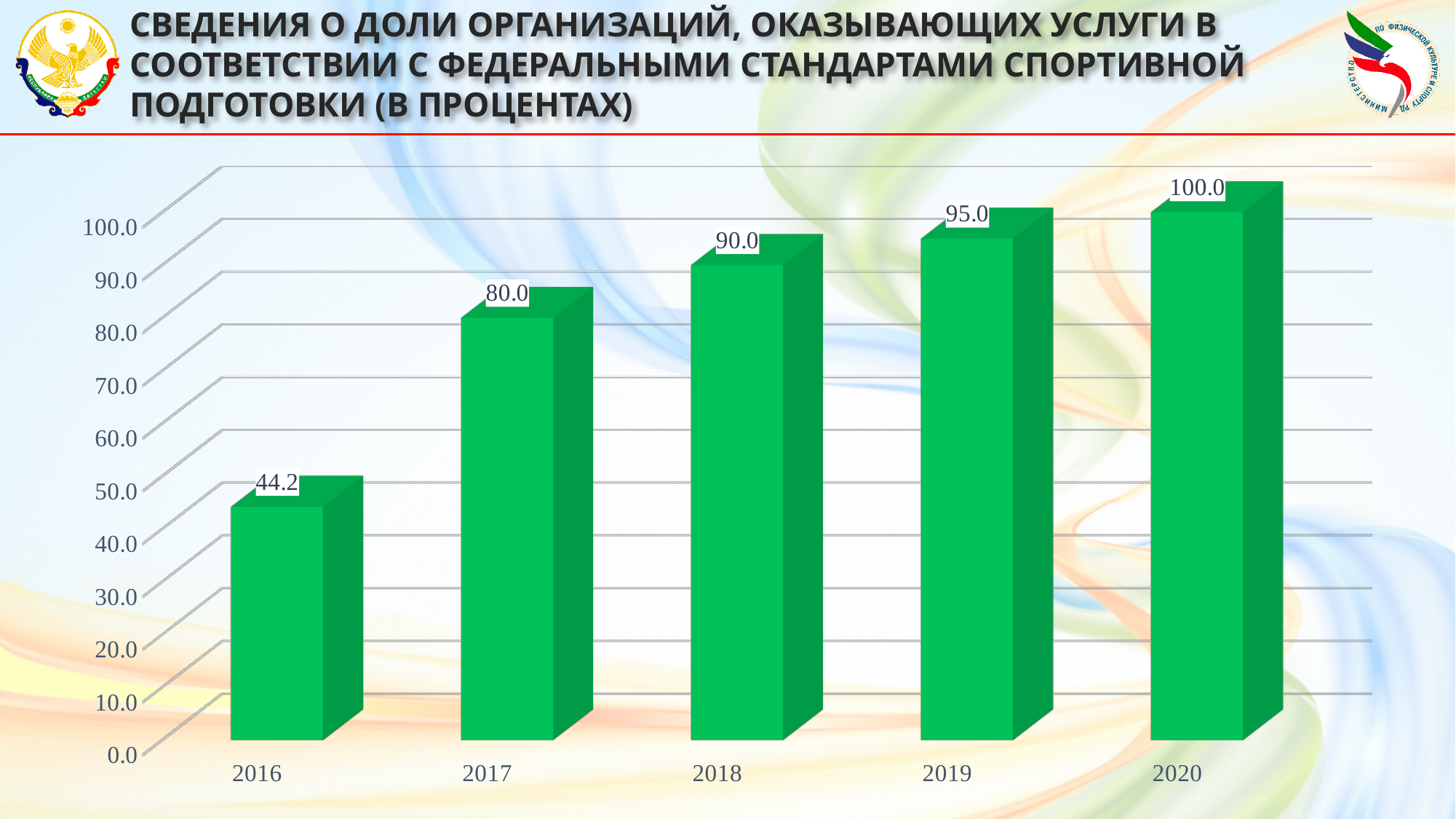
What is the difference between the values for 2020 and 2019? 5.0 How many years are shown on the x axis? 5 What kind of chart is shown on the slide? bar chart Do the values rise or fall from 2016 to 2020? rise Which year has the lowest value? 2016 Which is larger, the value for 2018 or the value for 2019? 2019 Is the value for 2016 greater or less than 50.0? less Which year has the highest value? 2020 What is the value for 2018? 90.0 What is the value for 2016? 44.2 What is the difference between the values for 2017 and 2016? 35.8 What is the value for 2020? 100.0